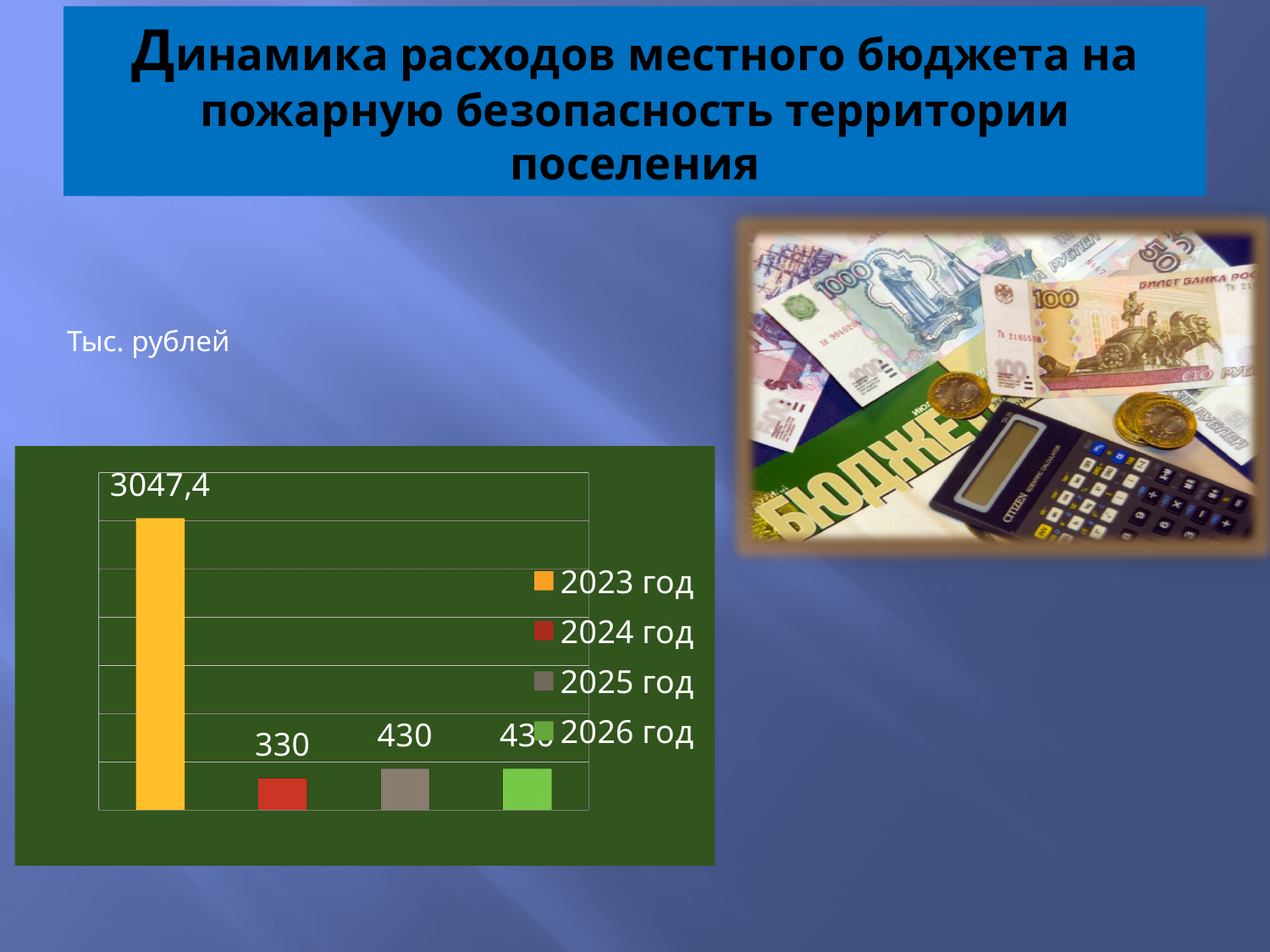
What is the difference between the values for 2023 год and 2024 год? 2717,4 Which is larger, the value for 2023 год or the value for 2025 год? 2023 год What is the value for 2024 год? 330 Which year has the lowest value? 2024 год What kind of chart is shown on the slide? bar chart What is the value for 2025 год? 430 Which year has the highest value? 2023 год How many entries does the legend list? 4 What is the difference between the values for 2025 год and 2024 год? 100 How many bars are plotted in the chart? 4 What is the value for 2023 год? 3047,4 What unit is stated for the chart values? Тыс. рублей